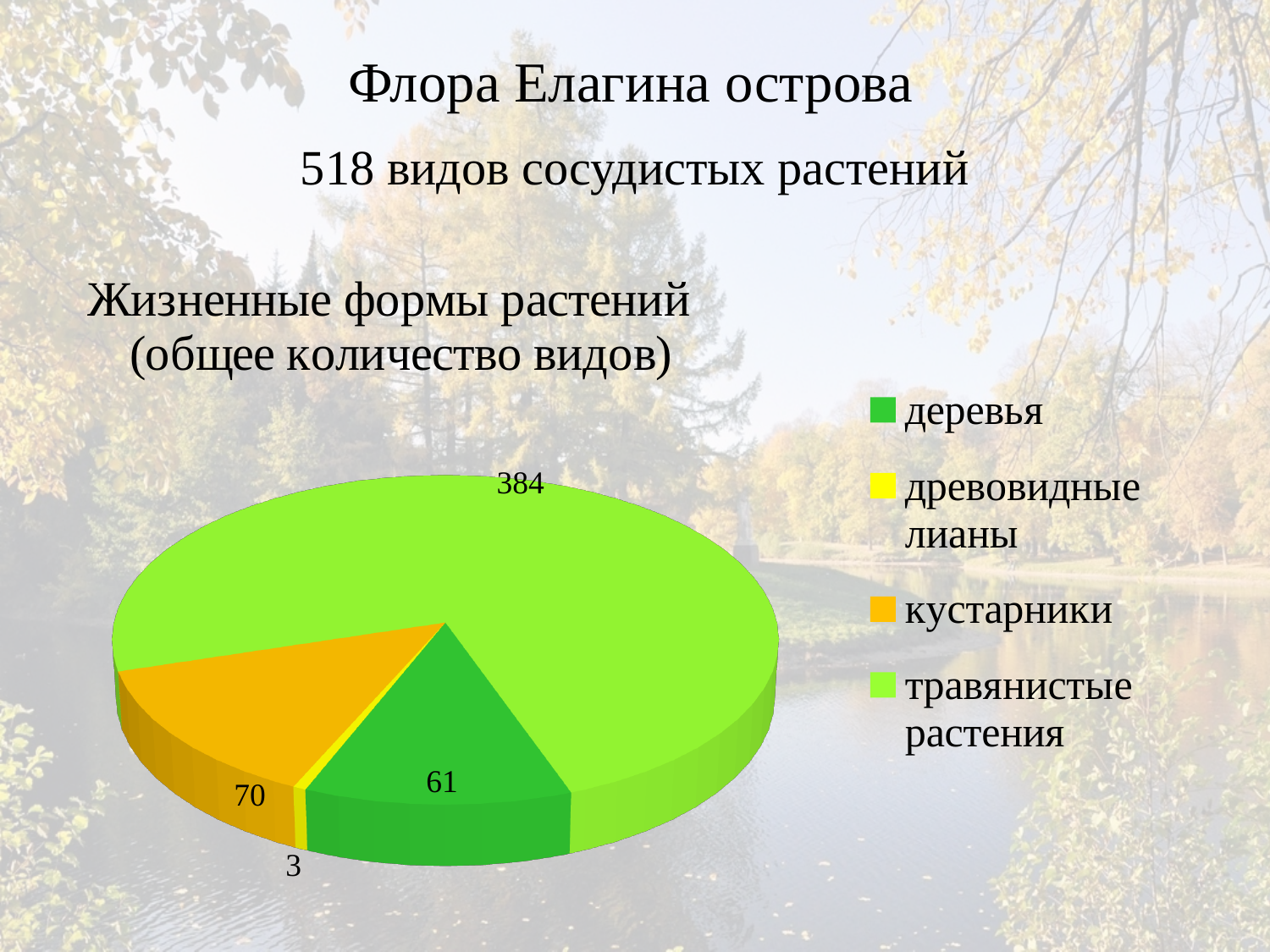
Which category has the largest slice? травянистые растения Which is larger, the value for кустарники or the value for деревья? кустарники What type of chart is shown on the slide? pie chart What is the value for деревья? 61 Which category has the smallest slice? древовидные лианы What is the title of the chart? Жизненные формы растений (общее количество видов) What is the value for древовидные лианы? 3 What is the difference between the values for травянистые растения and кустарники? 314 How many categories does the pie chart have? 4 What is the value for травянистые растения? 384 What colour is the slice for кустарники? orange What is the value for кустарники? 70